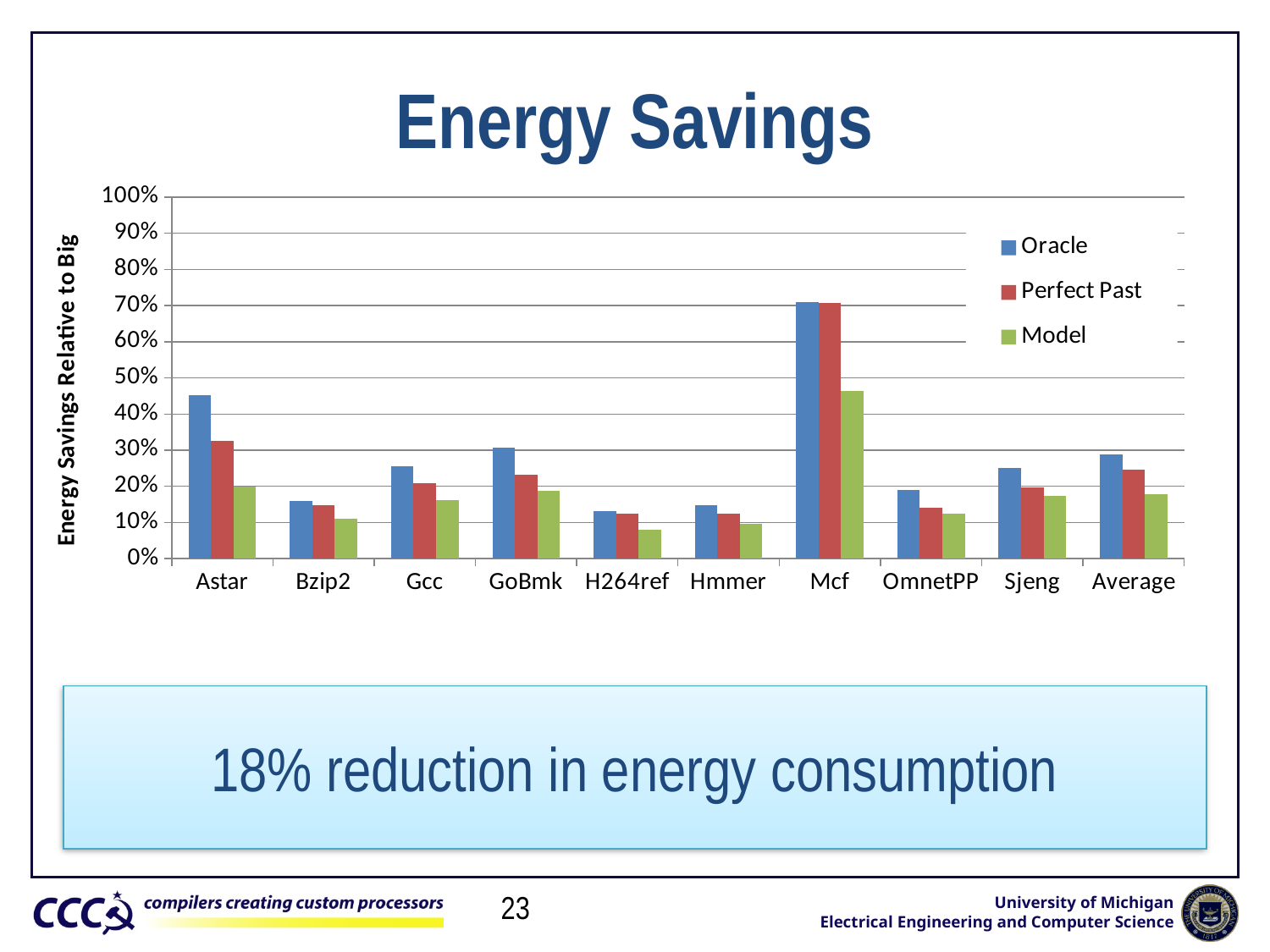
Which category has the highest Model value? Mcf Is the Model value for Mcf greater or less than 40%? greater Is the Oracle value for Astar greater or less than 40%? greater For Astar, which is larger: the Oracle value or the Perfect Past value? Oracle What is the title of the y axis? Energy Savings Relative to Big Which category has the lowest Model value? H264ref What kind of chart is shown on the slide? bar chart How many categories are shown along the x axis? 10 How many series does the legend list? 3 Which category has the highest Oracle value? Mcf Is the Model value for Average greater or less than 20%? less Which is larger: the Oracle value for Gcc or the Oracle value for Bzip2? Gcc